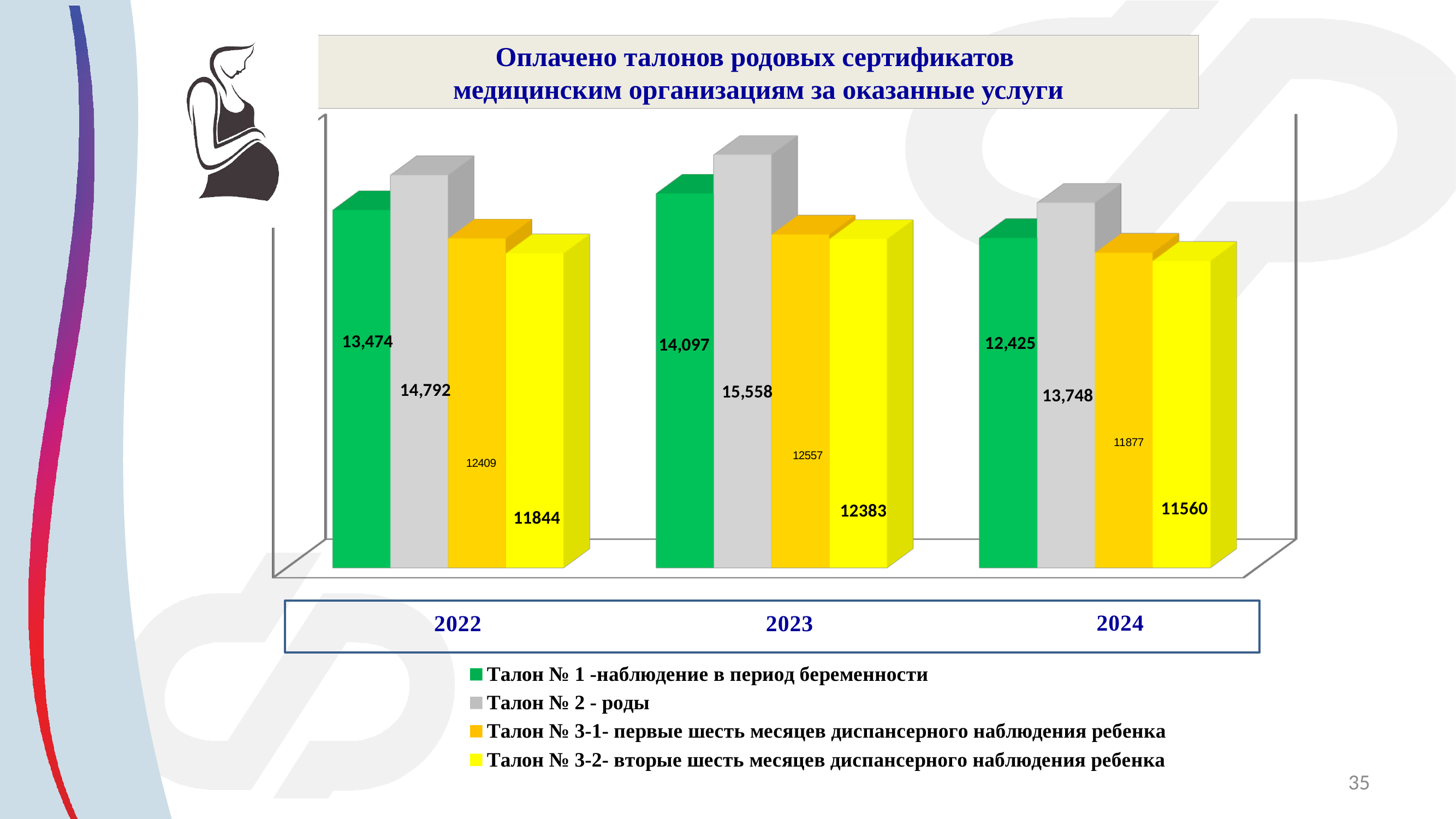
What is the difference between Талон № 2 and Талон № 1 in 2024? 1,323 What is the value for Талон № 2 (роды) in 2023? 15,558 How many series does the legend list? 4 In which year is the value for Талон № 3-2 the lowest? 2024 Which is larger in 2022: Талон № 3-1 or Талон № 3-2? Талон № 3-1 What kind of chart is shown on the slide? Bar chart How many years are shown on the x axis? 3 Which colour represents Талон № 2 - роды in the chart? Grey In which year is the value for Талон № 2 (роды) the highest? 2023 What is the value for Талон № 3-2 in 2023? 12383 What is the value for Талон № 1 (наблюдение в период беременности) in 2022? 13,474 What is the value for Талон № 3-1 in 2024? 11877